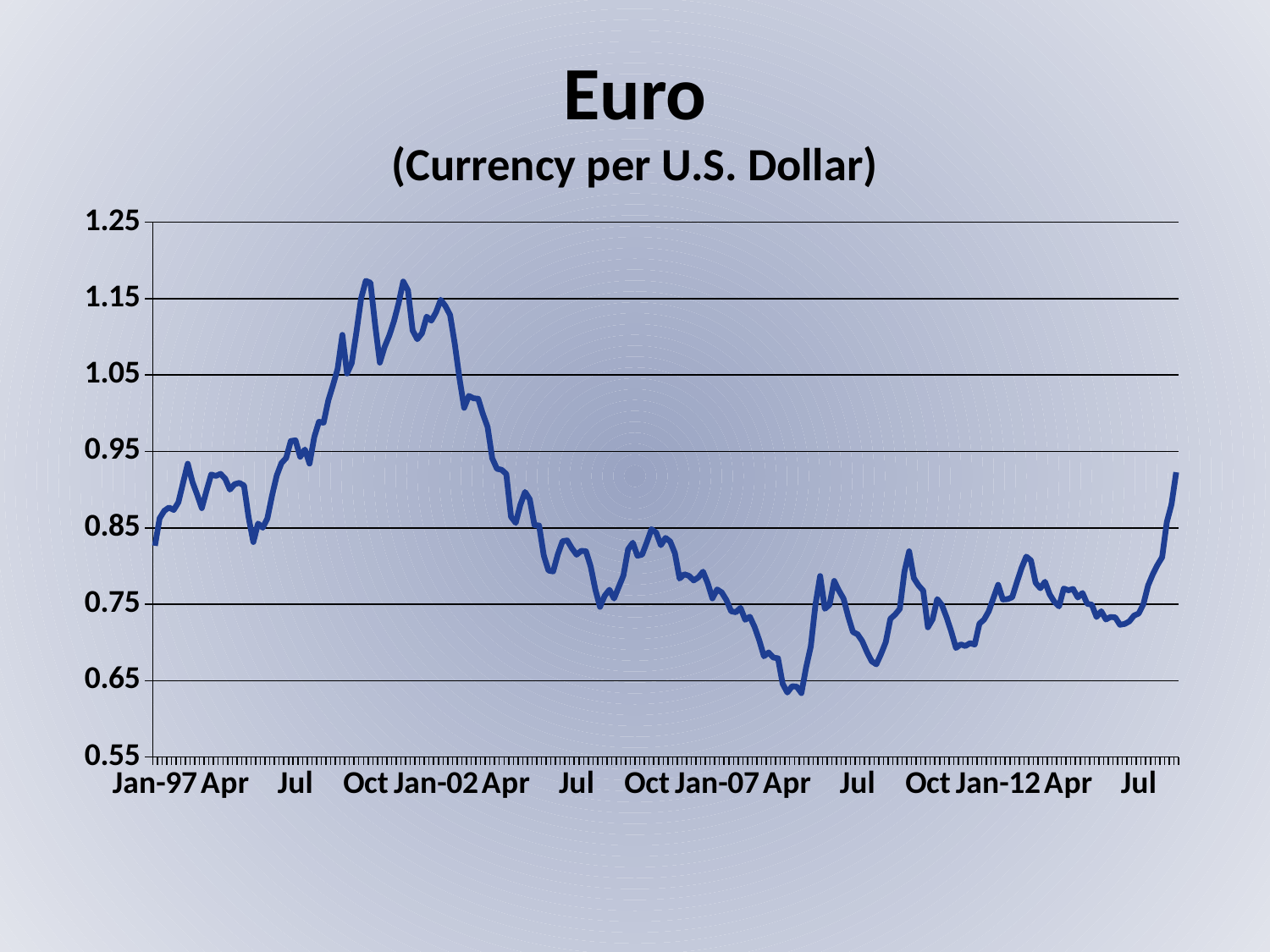
Is the lowest point of the line, reached between Jan-07 and Jul, greater or less than 0.75? less Is the value at the right-hand end of the line greater or less than 0.85? greater How many labels are printed along the horizontal axis? 15 Is the value at Jan-12 greater or less than 0.65? greater What unit does the chart subtitle say the values are in? Currency per U.S. Dollar What is the highest value shown on the vertical axis? 1.25 Does the line generally rise or fall between Jan-02 and Jan-07? fall What kind of chart is shown on the slide? line chart Does the line generally rise or fall between Jan-97 and its peak near Jan-02? rise What is the title of the chart? Euro